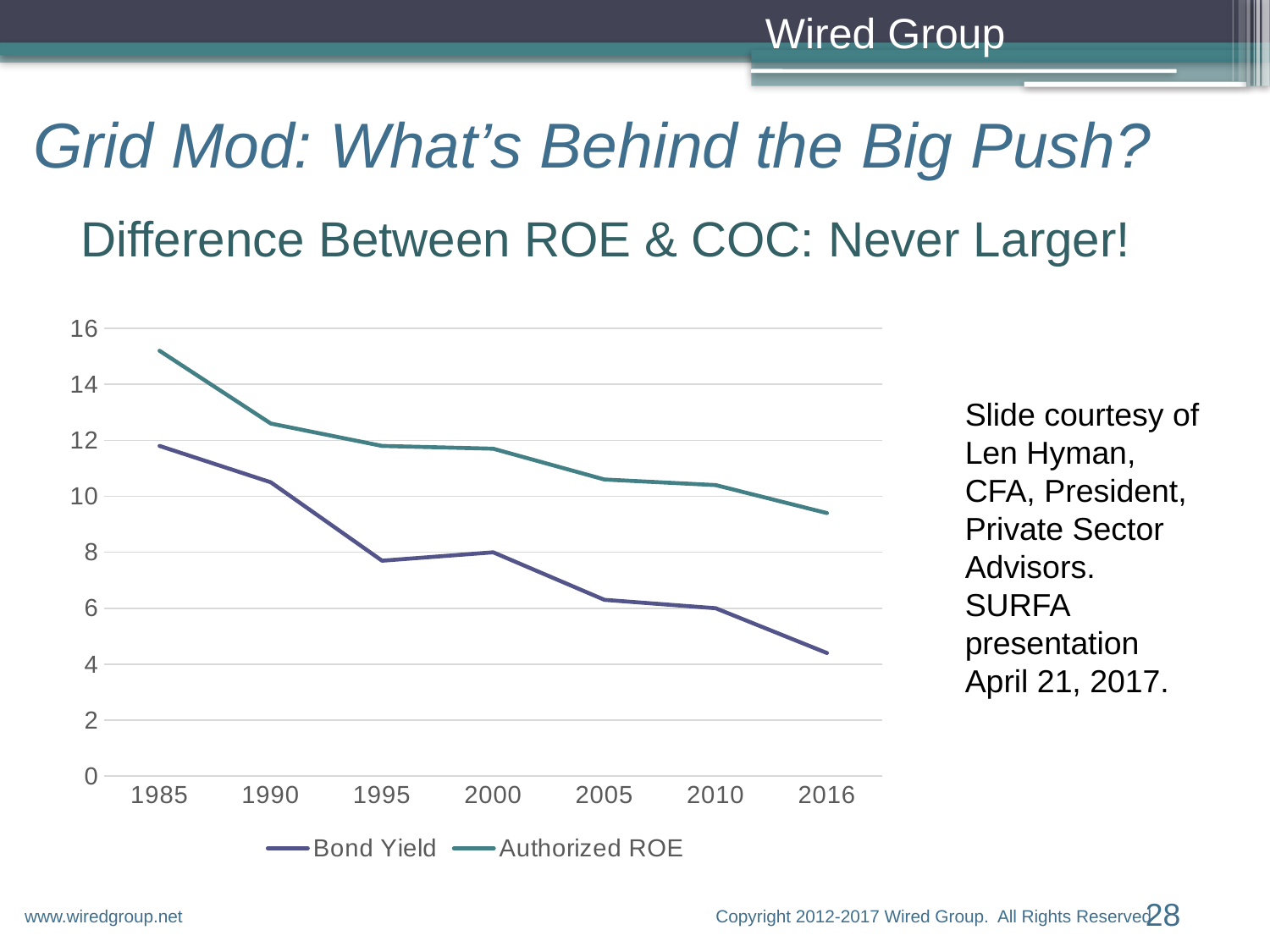
How many series does the chart's legend list? 2 Does the Authorized ROE line generally rise or fall from 1985 to 2016? fall What kind of chart is shown on the slide? line chart Is the Bond Yield value for 2016 greater or less than 6? less Is the Authorized ROE value for 2016 greater or less than 10? less In which year is Bond Yield at its lowest? 2016 How many years are plotted along the x axis of the chart? 7 Is the Authorized ROE value for 1985 greater or less than 14? greater Does the Bond Yield line generally rise or fall from 1985 to 2016? fall What are the two series named in the chart's legend? Bond Yield and Authorized ROE In which year is Authorized ROE at its highest? 1985 In 1985, which is larger: Bond Yield or Authorized ROE? Authorized ROE